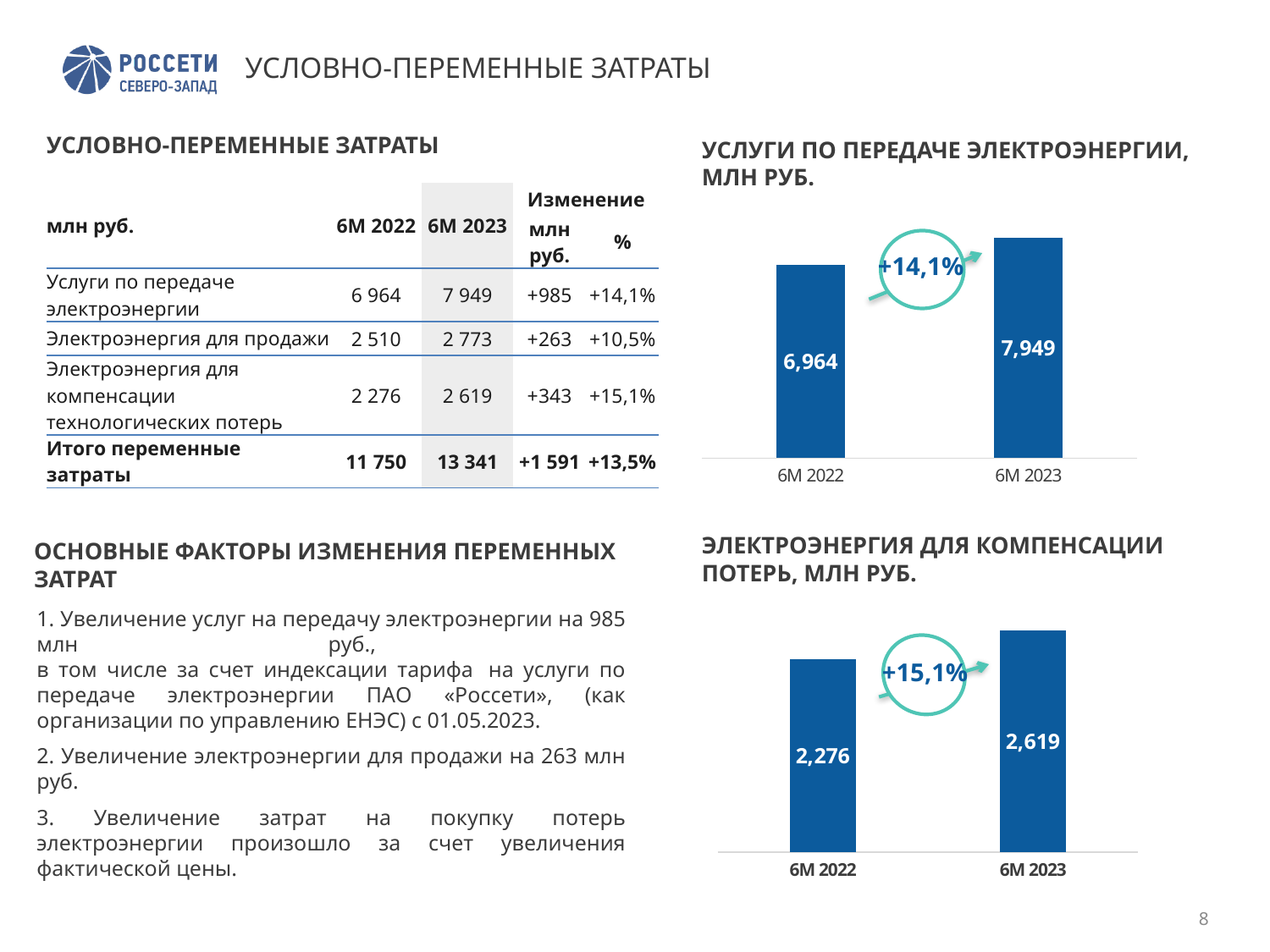
In the chart titled 'ЭЛЕКТРОЭНЕРГИЯ ДЛЯ КОМПЕНСАЦИИ ПОТЕРЬ, МЛН РУБ.', what is the value for 6M 2023? 2,619 In the chart titled 'ЭЛЕКТРОЭНЕРГИЯ ДЛЯ КОМПЕНСАЦИИ ПОТЕРЬ, МЛН РУБ.', what is the difference between the 6M 2023 and 6M 2022 values? 343 In the chart titled 'УСЛУГИ ПО ПЕРЕДАЧЕ ЭЛЕКТРОЭНЕРГИИ, МЛН РУБ.', what is the value for 6M 2023? 7,949 In the chart titled 'ЭЛЕКТРОЭНЕРГИЯ ДЛЯ КОМПЕНСАЦИИ ПОТЕРЬ, МЛН РУБ.', which period has the lower value? 6M 2022 How many bars are shown in the chart titled 'ЭЛЕКТРОЭНЕРГИЯ ДЛЯ КОМПЕНСАЦИИ ПОТЕРЬ, МЛН РУБ.'? 2 What kind of chart is the one titled 'УСЛУГИ ПО ПЕРЕДАЧЕ ЭЛЕКТРОЭНЕРГИИ, МЛН РУБ.'? bar chart In the chart titled 'ЭЛЕКТРОЭНЕРГИЯ ДЛЯ КОМПЕНСАЦИИ ПОТЕРЬ, МЛН РУБ.', is the value for 6M 2022 larger or smaller than the value for 6M 2023? smaller In the chart titled 'УСЛУГИ ПО ПЕРЕДАЧЕ ЭЛЕКТРОЭНЕРГИИ, МЛН РУБ.', what is the difference between the 6M 2023 and 6M 2022 values? 985 In the chart titled 'ЭЛЕКТРОЭНЕРГИЯ ДЛЯ КОМПЕНСАЦИИ ПОТЕРЬ, МЛН РУБ.', what is the value for 6M 2022? 2,276 In the chart titled 'УСЛУГИ ПО ПЕРЕДАЧЕ ЭЛЕКТРОЭНЕРГИИ, МЛН РУБ.', what is the value for 6M 2022? 6,964 In the chart titled 'УСЛУГИ ПО ПЕРЕДАЧЕ ЭЛЕКТРОЭНЕРГИИ, МЛН РУБ.', what percentage change is shown between 6M 2022 and 6M 2023? +14,1% In the chart titled 'УСЛУГИ ПО ПЕРЕДАЧЕ ЭЛЕКТРОЭНЕРГИИ, МЛН РУБ.', which period has the higher value? 6M 2023